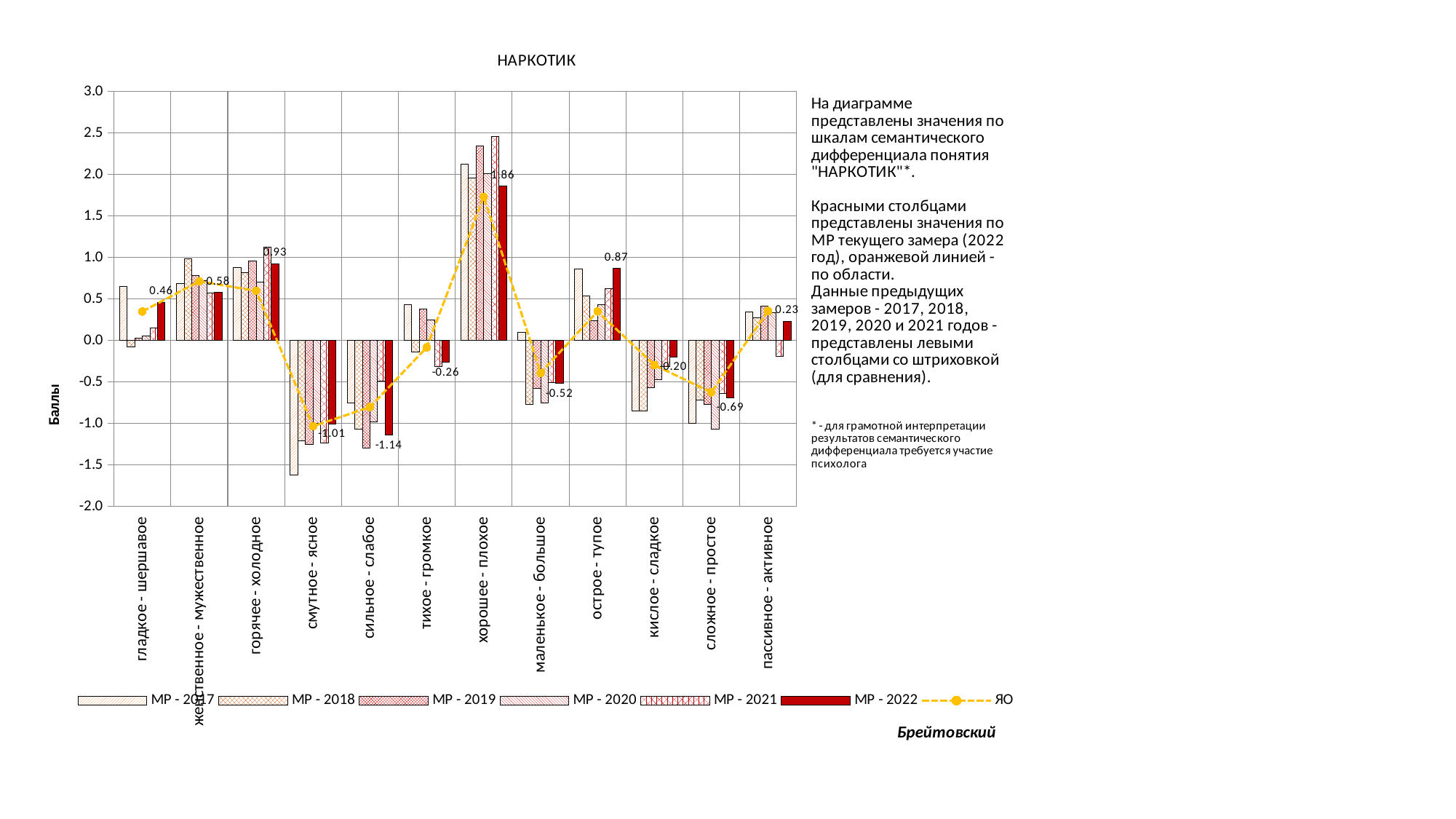
Is the ЯО value for смутное - ясное greater or less than -0.5? less How many scales (categories) are shown on the x axis? 12 What is the value of МР - 2022 for the scale кислое - сладкое? -0.20 Which has the larger МР - 2022 value: горячее - холодное or женственное - мужественное? горячее - холодное How many series does the legend list? 7 What is the title of the chart? НАРКОТИК Is the ЯО value for хорошее - плохое greater or less than 1.5? greater What is the difference between the МР - 2022 values for острое - тупое and гладкое - шершавое? 0.41 What is the value of МР - 2022 for the scale сильное - слабое? -1.14 Which scale has the lowest МР - 2022 value? сильное - слабое Which scale has the highest МР - 2022 value? хорошее - плохое What is the value of МР - 2022 for the scale хорошее - плохое? 1.86